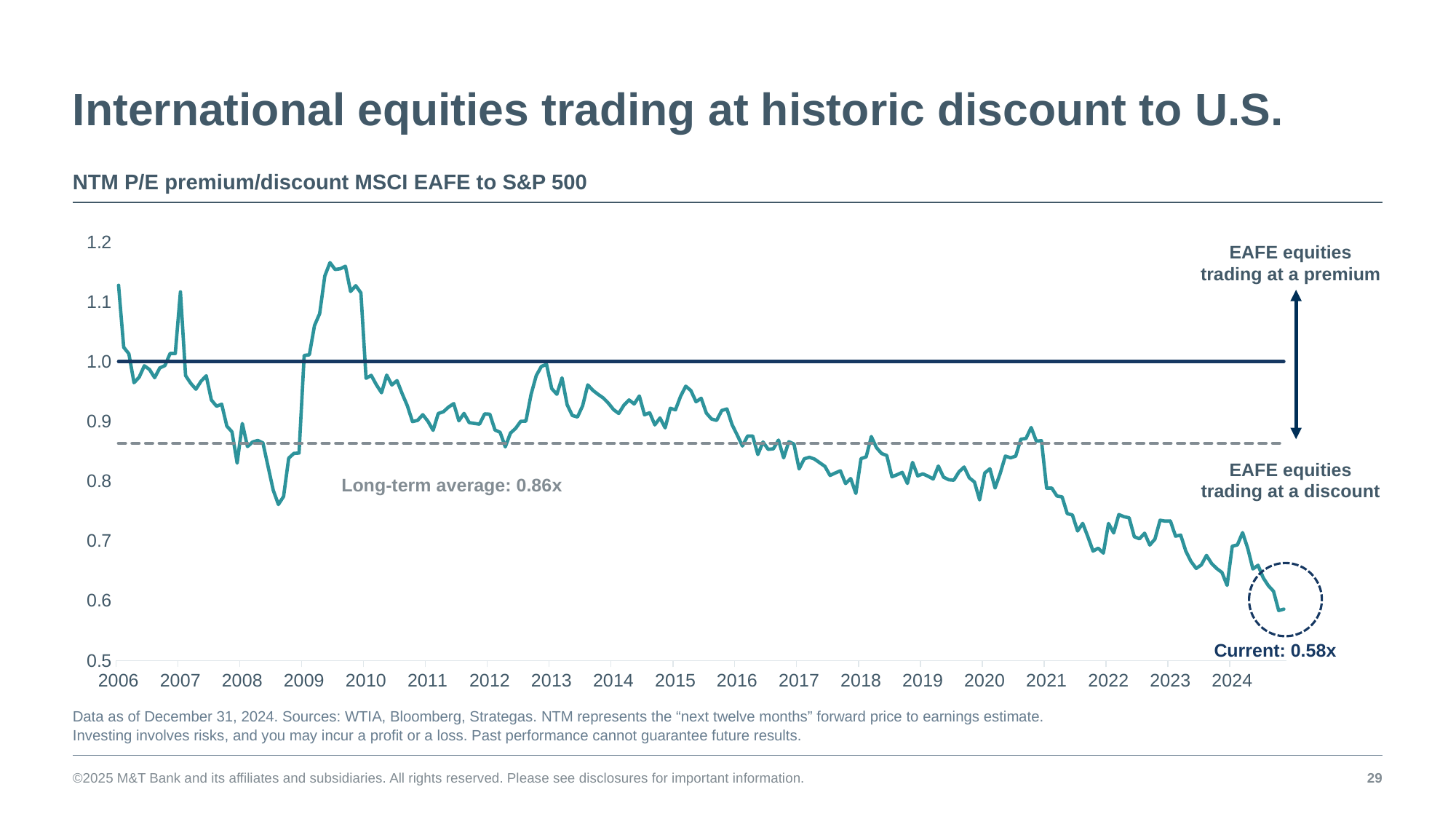
Is the value during 2022 greater or less than 0.8? less What is the title of the chart? NTM P/E premium/discount MSCI EAFE to S&P 500 Is the peak value reached between 2009 and 2010 greater or less than 1.1? greater What is the long-term average value marked by the dashed line on the chart? 0.86x Does the line generally rise or fall from 2021 to the end of 2024? fall What is the current NTM P/E premium/discount of MSCI EAFE to the S&P 500 shown on the chart? 0.58x What is the difference between the long-term average (0.86x) and the current value (0.58x)? 0.28x Is the value at the start of 2006 greater or less than 1.0? greater What kind of chart is shown on the slide? line chart How many year labels are shown on the x axis? 19 Which is larger, the current value or the long-term average? the long-term average